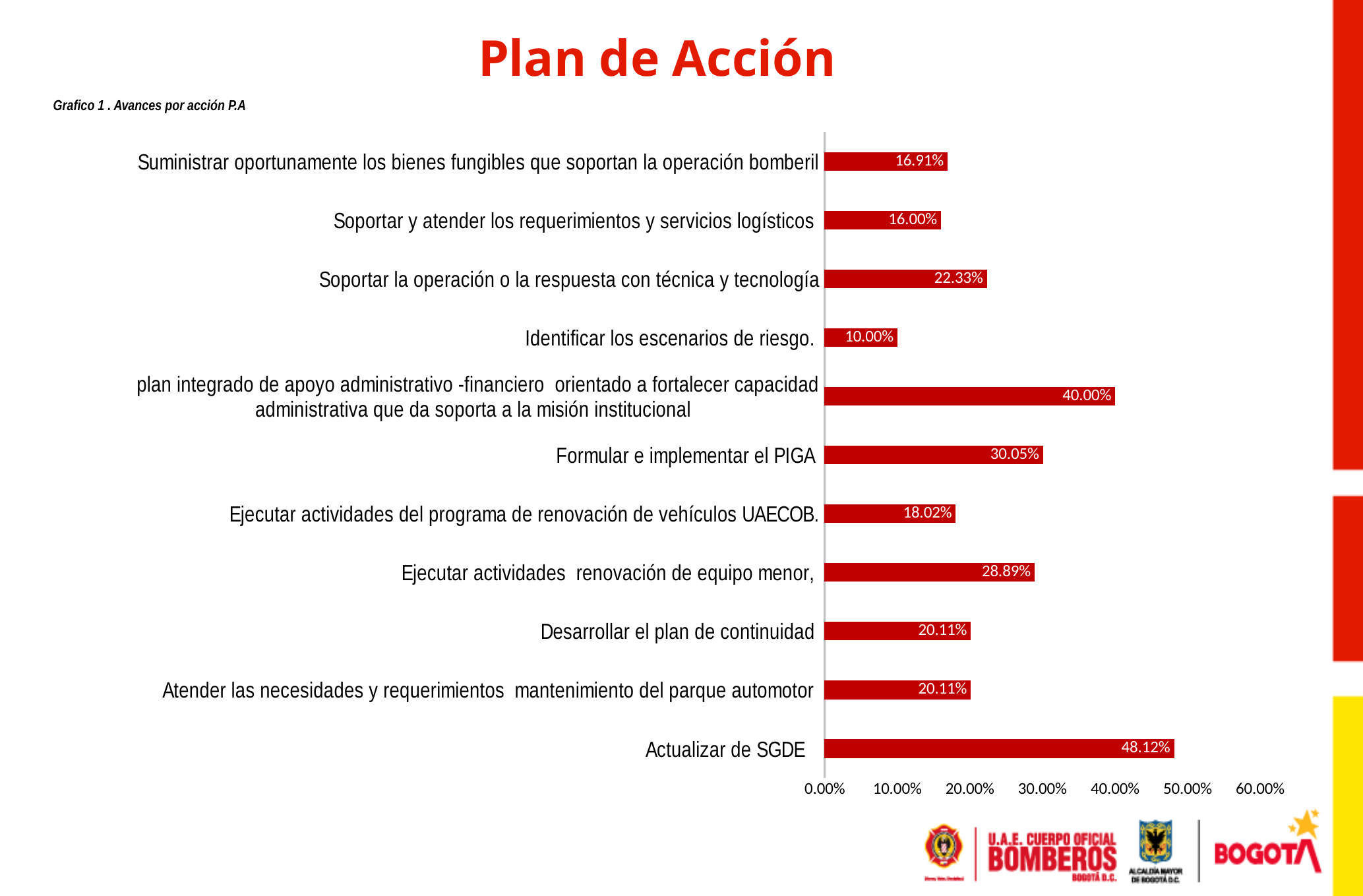
Which category has the highest value? Actualizar de SGDE Which is larger: the value for "Ejecutar actividades renovación de equipo menor," or the value for "Ejecutar actividades del programa de renovación de vehículos UAECOB."? Ejecutar actividades renovación de equipo menor, What is the value for "Actualizar de SGDE"? 48.12% What is the value for "Identificar los escenarios de riesgo."? 10.00% What is the caption of the chart? Grafico 1 . Avances por acción P.A How many categories are shown in the chart? 11 Is the value for the "plan integrado de apoyo administrativo -financiero" category greater or less than 30.00%? greater Which category has the lowest value? Identificar los escenarios de riesgo. What kind of chart is shown on the slide? Bar chart What is the difference between the values for "Actualizar de SGDE" and "Formular e implementar el PIGA"? 18.07% What is the value for "Formular e implementar el PIGA"? 30.05% What is the value for "Soportar la operación o la respuesta con técnica y tecnología"? 22.33%